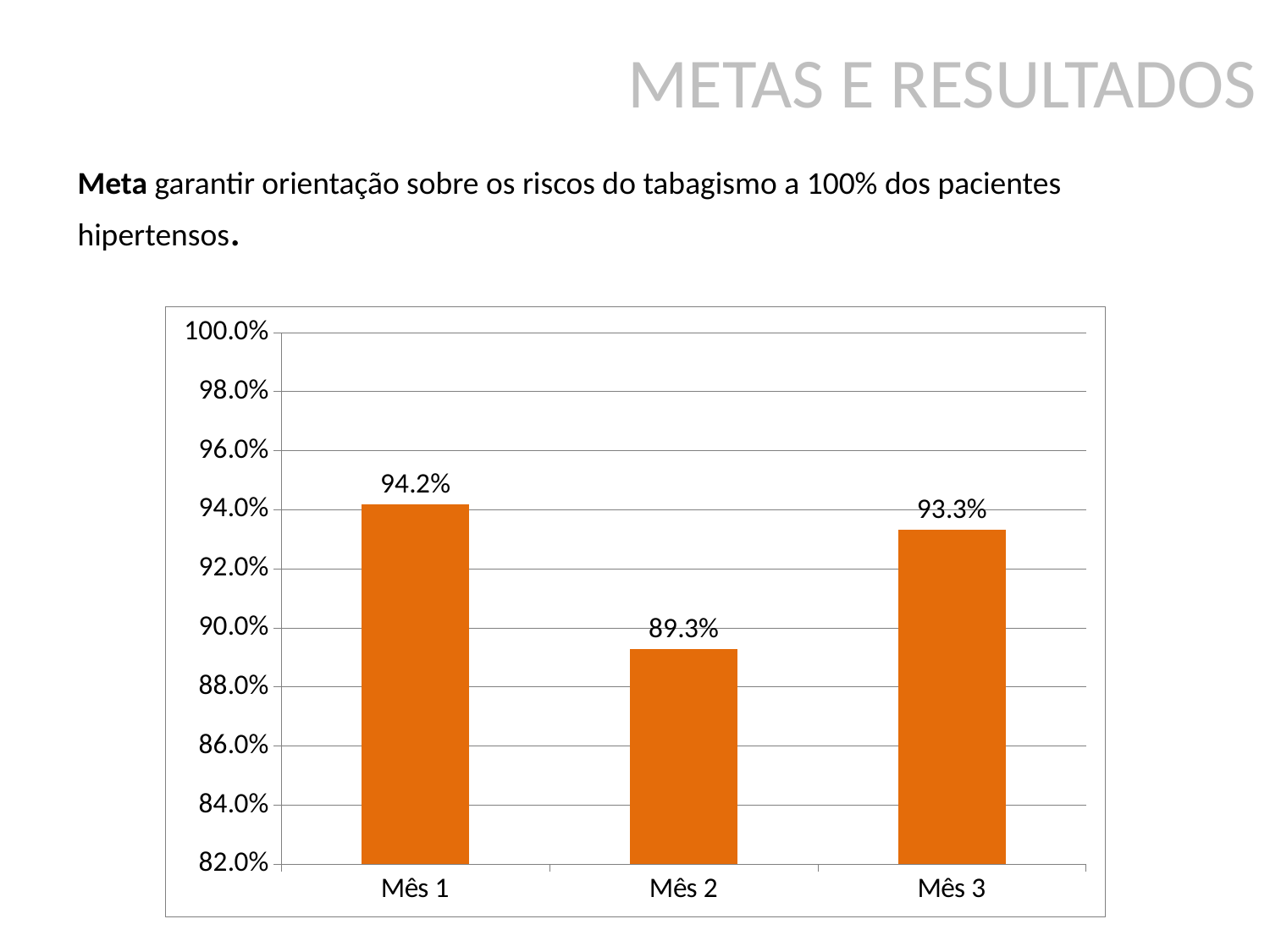
What is the value for Mês 3? 93.3% What is the difference between the values for Mês 3 and Mês 2? 4.0% What is the value for Mês 1? 94.2% How many categories are shown on the x axis? 3 Which is larger, the value for Mês 1 or the value for Mês 3? Mês 1 Is the value for Mês 2 greater or less than 90.0%? less What is the value for Mês 2? 89.3% What is the difference between the values for Mês 1 and Mês 2? 4.9% What colour are the bars in the chart? orange Which month has the lowest value? Mês 2 What kind of chart is shown on the slide? bar chart Which month has the highest value? Mês 1